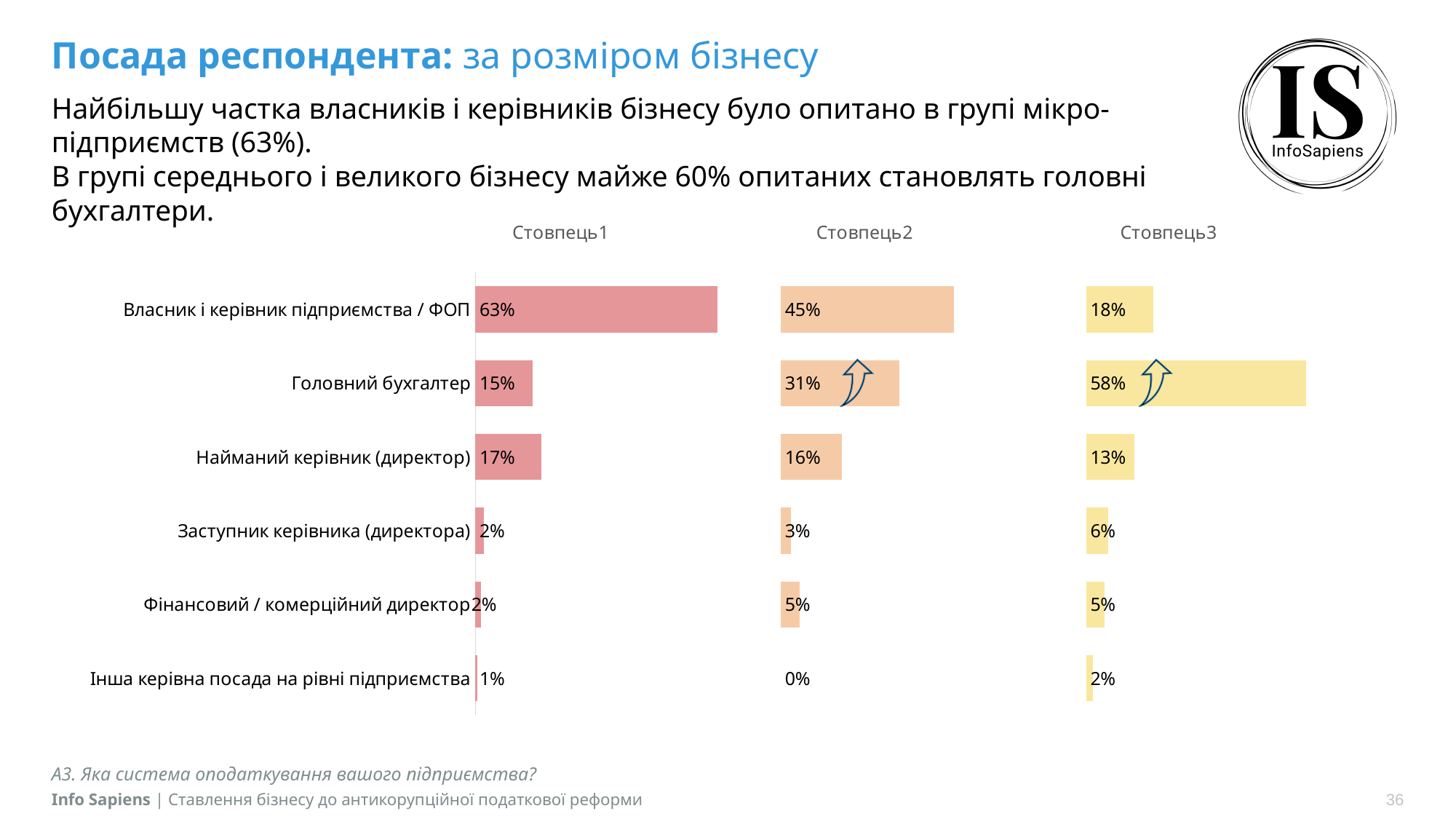
What is the value for Заступник керівника (директора) in Стовпець3? 6% What is the value for Власник і керівник підприємства / ФОП in Стовпець1? 63% How many categories are shown on the chart? 6 What is the value for Інша керівна посада на рівні підприємства in Стовпець2? 0% What is the difference between the Стовпець1 and Стовпець3 values for Власник і керівник підприємства / ФОП? 45% What kind of chart is shown on the slide? Bar chart What is the value for Найманий керівник (директор) in Стовпець2? 16% Which is larger for Головний бухгалтер: the value in Стовпець2 or in Стовпець3? Стовпець3 Which category has the lowest value in Стовпець1? Інша керівна посада на рівні підприємства Which category has the highest value in Стовпець3? Головний бухгалтер How many series does the chart show? 3 What is the value for Головний бухгалтер in Стовпець3? 58%